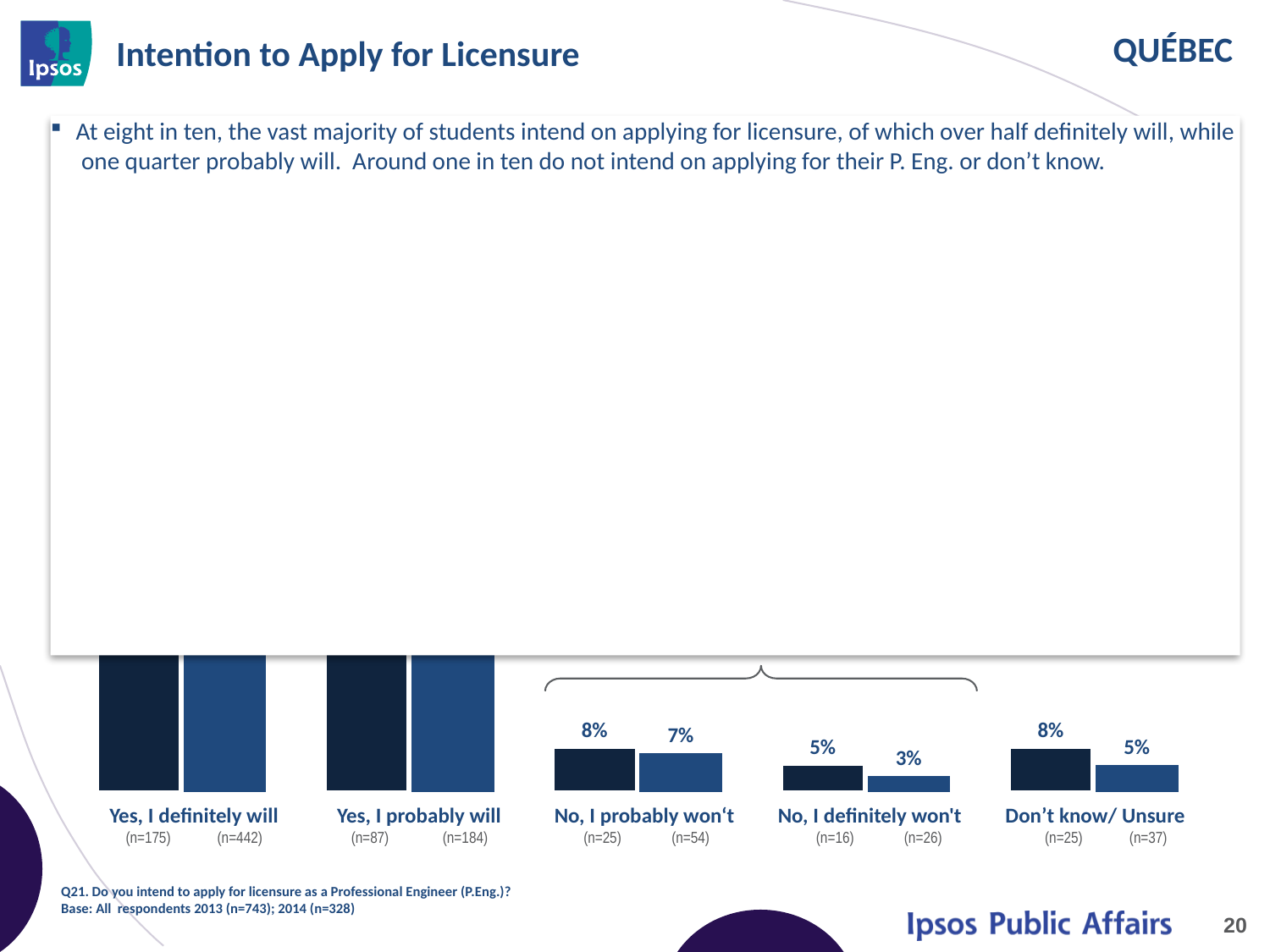
What is the title of the slide containing the chart? Intention to Apply for Licensure Which is larger: the dark bar for "No, I probably won't" or the dark bar for "No, I definitely won't"? No, I probably won't What is the value of the lighter (right) bar for "No, I definitely won't"? 3% What is the value of the dark (left) bar for "No, I probably won't"? 8% What kind of chart is shown on the slide? Bar chart What is the value of the lighter (right) bar for "No, I probably won't"? 7% What is the value of the dark (left) bar for "Don't know/ Unsure"? 8% What is the difference between the dark bar and the lighter bar for "No, I definitely won't"? 2 percentage points What is the difference between the dark bar and the lighter bar for "Don't know/ Unsure"? 3 percentage points For "No, I definitely won't", which bar is larger, the dark (left) bar or the lighter (right) bar? The dark (left) bar How many categories are shown along the x axis of the chart? 5 Which category has the tallest bars in the chart? Yes, I definitely will